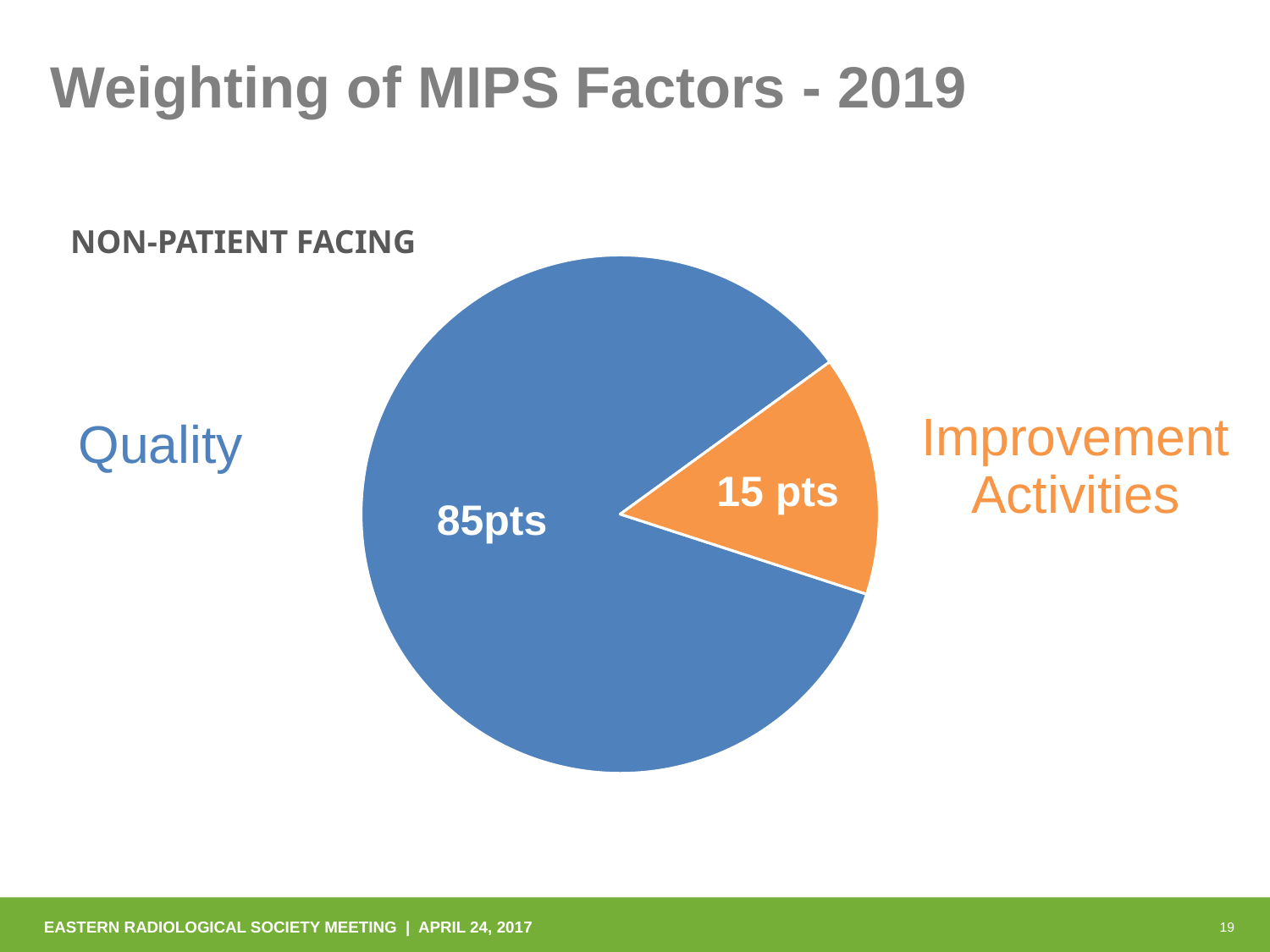
Which is larger, the value for Quality or the value for Improvement Activities? Quality Which category has the smallest slice of the pie? Improvement Activities How many points are shown for Improvement Activities? 15 pts What share of the pie does the Quality slice represent? 85% What is the difference in points between Quality and Improvement Activities? 70 pts How many points are shown for Quality? 85pts What is the title of the slide containing the pie chart? Weighting of MIPS Factors - 2019 What colour is the Improvement Activities slice? orange What is the total number of points across both slices of the pie? 100 pts Which category has the largest slice of the pie? Quality How many slices does the pie chart have? 2 What kind of chart is shown on the slide? pie chart